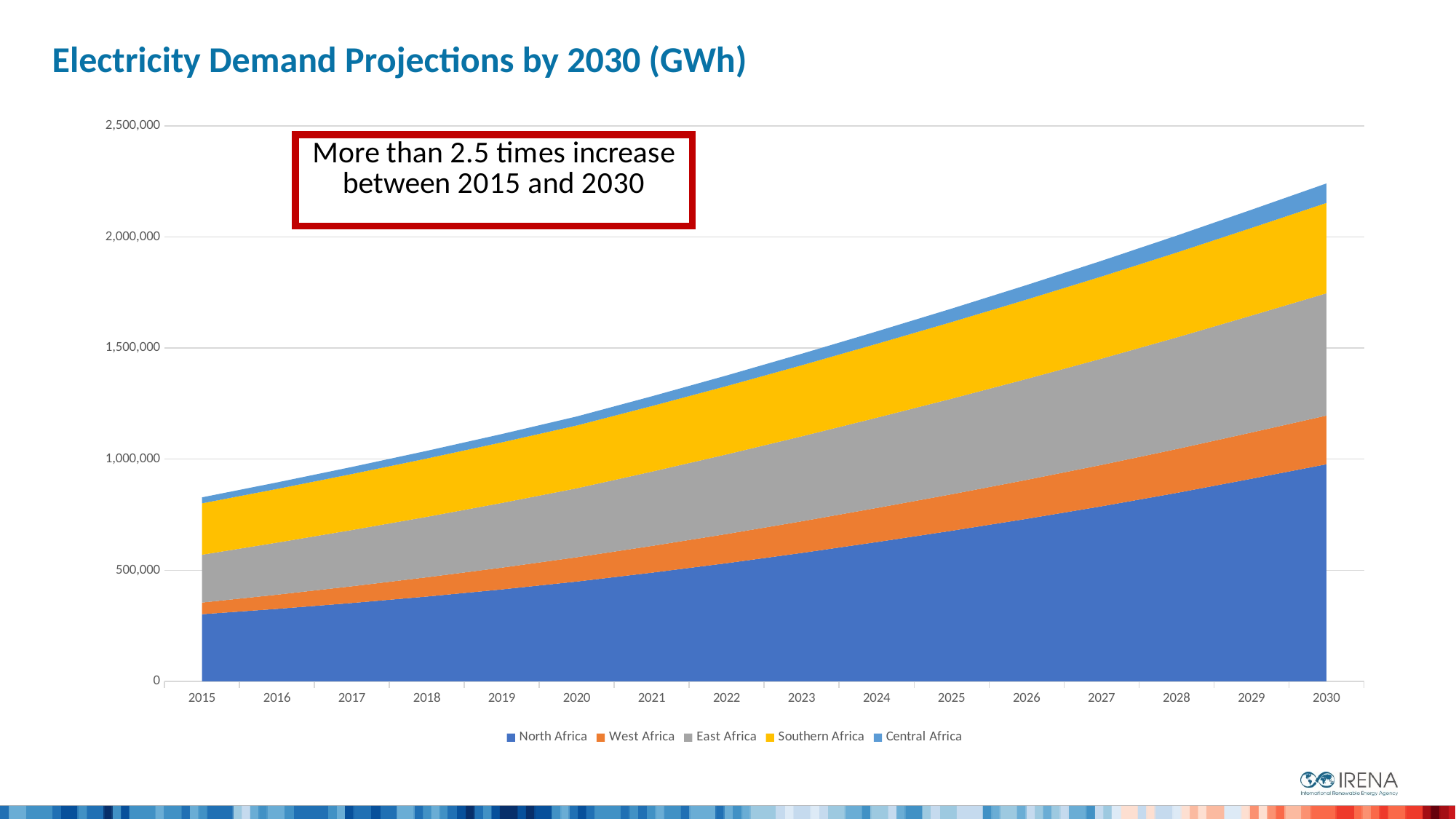
What kind of chart is shown on the slide? Stacked area chart What is the title of the chart? Electricity Demand Projections by 2030 (GWh) Does total electricity demand rise or fall from 2015 to 2030? Rises Is the total electricity demand in 2015 greater or less than 1,000,000? less Which region has the larger electricity demand in 2030, East Africa or West Africa? East Africa How many series does the legend list? 5 Which region accounts for the largest share of electricity demand in 2030? North Africa How many years are shown along the x axis? 16 Is the total electricity demand in 2020 greater or less than 1,000,000? greater Is the total electricity demand in 2030 greater or less than 2,000,000? greater Which region accounts for the smallest share of electricity demand in 2030? Central Africa